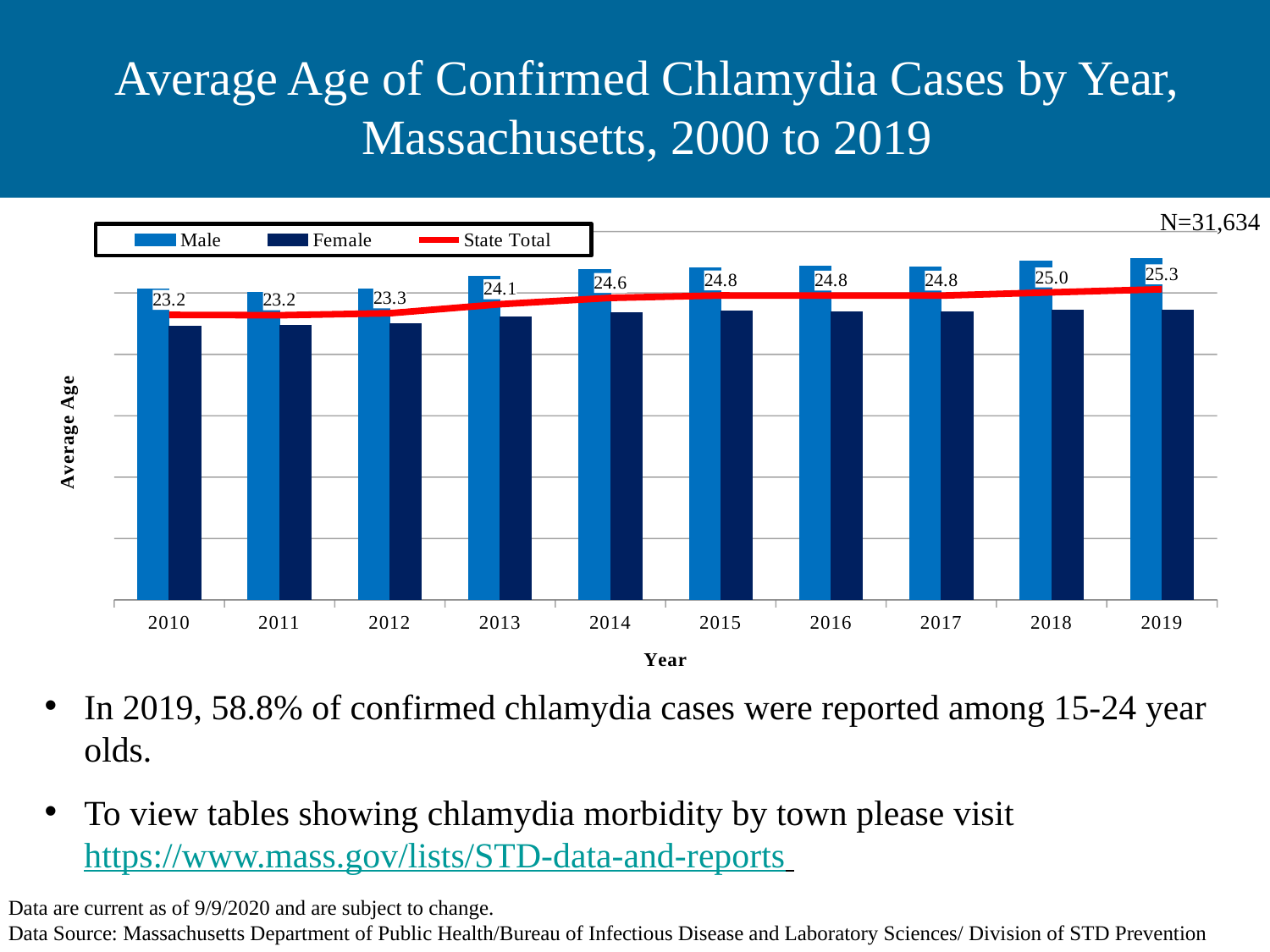
What is the difference between the State Total average age in 2014 and in 2013? 0.5 What is the State Total average age for 2019? 25.3 In 2015, is the Male bar or the Female bar taller? Male How many years are shown on the x axis? 10 Is the State Total average age higher in 2018 or in 2012? 2018 How many series does the legend list? 3 What is the difference between the State Total average age in 2019 and in 2010? 2.1 What is the State Total average age for 2013? 24.1 What is the N value shown above the chart? N=31,634 Which year has the highest State Total average age? 2019 Does the State Total average age generally rise or fall from 2010 to 2019? rise What is the State Total average age for 2010? 23.2